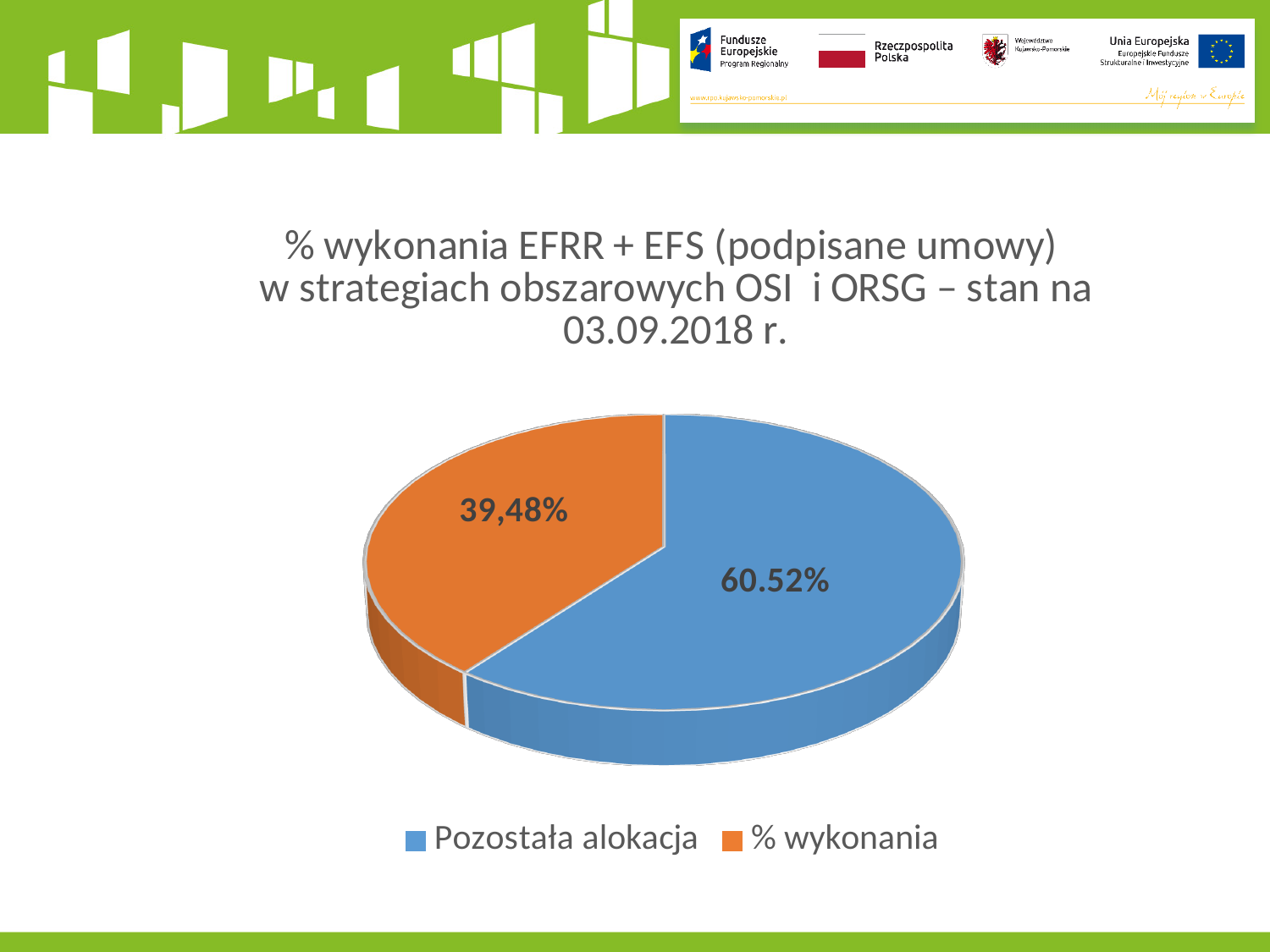
Which slice is the smallest? % wykonania What is the value shown for "Pozostała alokacja"? 60.52% What colour is the "Pozostała alokacja" slice? blue Which slice is the largest? Pozostała alokacja Which is larger, "Pozostała alokacja" or "% wykonania"? Pozostała alokacja What is the value shown for "% wykonania"? 39,48% What kind of chart is shown on the slide? pie chart What share of the pie does "% wykonania" represent? 39,48% How many entries does the legend list? 2 What colour is the "% wykonania" slice? orange How many slices does the pie chart have? 2